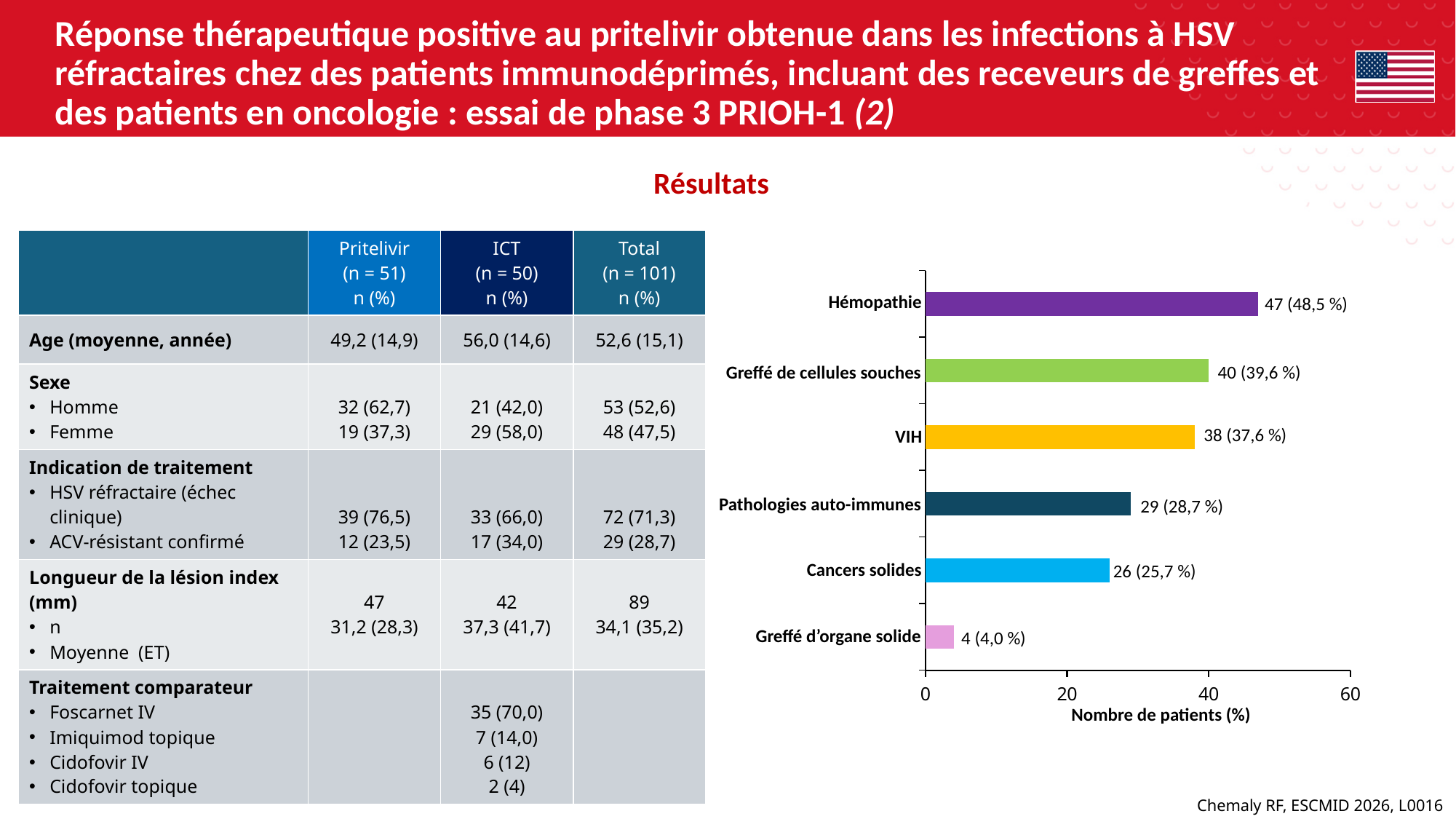
What is the x-axis title of the bar chart? Nombre de patients (%) What is the data label for Greffé d'organe solide in the bar chart? 4 (4,0 %) Which has a larger value, Pathologies auto-immunes or Cancers solides? Pathologies auto-immunes How many categories does the bar chart show? 6 What is the data label for VIH in the bar chart? 38 (37,6 %) What is the difference in number of patients between Greffé de cellules souches and Cancers solides? 14 Is the value for Greffé de cellules souches greater or less than 20? greater Which category has the highest value in the bar chart? Hémopathie What is the maximum value shown on the x axis of the bar chart? 60 What is the data label for Hémopathie in the bar chart? 47 (48,5 %) Which category has the lowest value in the bar chart? Greffé d'organe solide What type of chart is shown on the slide? bar chart